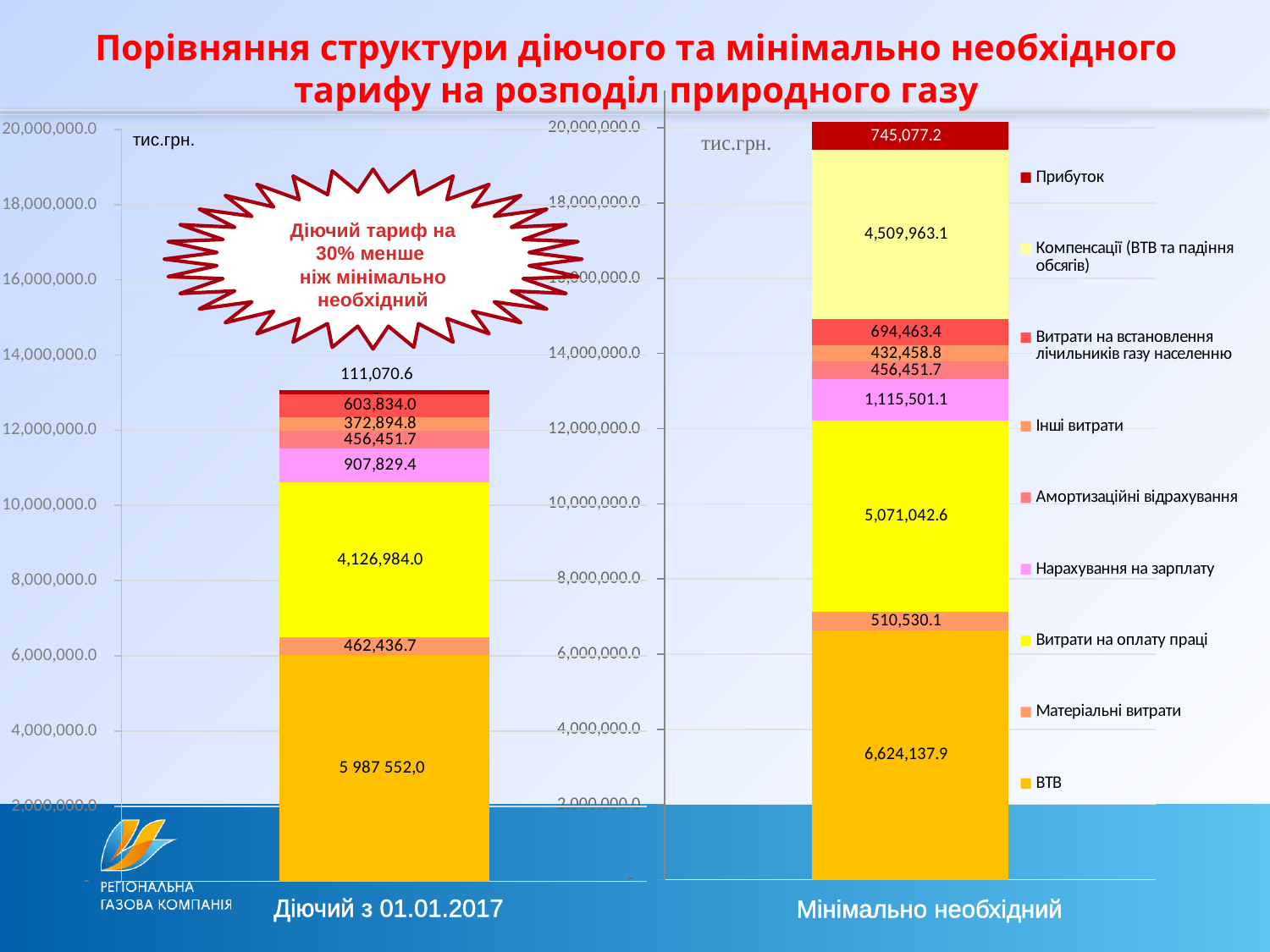
In the 'Мінімально необхідний' bar, what is the value of the 'ВТВ' (orange, bottom) segment? 6,624,137.9 What is the difference between the 'Витрати на оплату праці' values in the 'Мінімально необхідний' bar (5,071,042.6) and the 'Діючий з 01.01.2017' bar (4,126,984.0)? 944,058.6 According to the starburst callout on the slide, by what percentage is the current tariff lower than the minimally required one? 30% Is the total height of the 'Діючий з 01.01.2017' bar greater or less than 14,000,000.0? less In the 'Мінімально необхідний' bar, what is the value of the 'Прибуток' (dark red, top) segment? 745,077.2 In the 'Мінімально необхідний' bar, what is the value of the 'Витрати на оплату праці' (yellow) segment? 5,071,042.6 How many entries does the legend list? 9 Which bar has the larger 'Нарахування на зарплату' (pink) segment: 'Діючий з 01.01.2017' (907,829.4) or 'Мінімально необхідний' (1,115,501.1)? Мінімально необхідний What kind of chart is shown on the slide? Stacked bar chart In the 'Діючий з 01.01.2017' bar, what is the value of the 'Витрати на оплату праці' (yellow) segment? 4,126,984.0 In the 'Мінімально необхідний' bar, what is the value of the 'Компенсації (ВТВ та падіння обсягів)' (light yellow) segment? 4,509,963.1 In the 'Діючий з 01.01.2017' bar, what is the value of the 'ВТВ' (orange, bottom) segment? 5 987 552,0